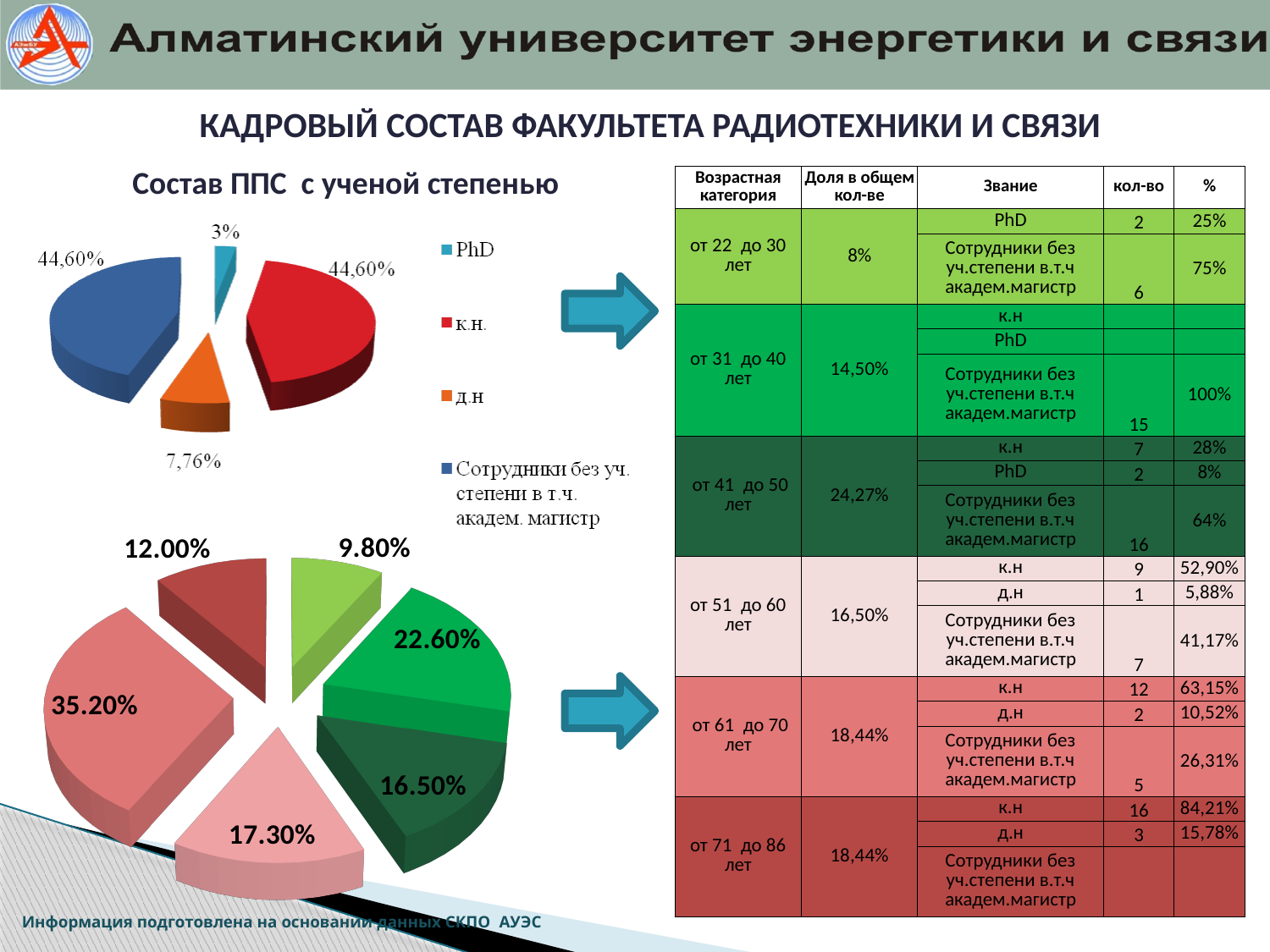
How many slices does the lower-left pie chart on the slide have? 6 How many entries does the legend of the pie chart titled 'Состав ППС с ученой степенью' list? 4 In the lower-left pie chart, what is the difference between the largest slice (35.20%) and the smallest slice (9.80%)? 25.40% In the pie chart titled 'Состав ППС с ученой степенью', what share is shown for д.н? 7,76% What kind of chart is the chart titled 'Состав ППС с ученой степенью'? Pie chart In the pie chart titled 'Состав ППС с ученой степенью', what share is shown for PhD? 3% In the pie chart titled 'Состав ППС с ученой степенью', which category has the smallest share? PhD In the pie chart titled 'Состав ППС с ученой степенью', which is larger: к.н. or д.н? к.н. In the pie chart titled 'Состав ППС с ученой степенью', what share is shown for к.н.? 44,60% In the lower-left pie chart, what is the value of the largest slice? 35.20% In the pie chart titled 'Состав ППС с ученой степенью', what is the difference between the share for к.н. and the share for д.н? 36,84% In the lower-left pie chart, what is the value of the smallest slice? 9.80%